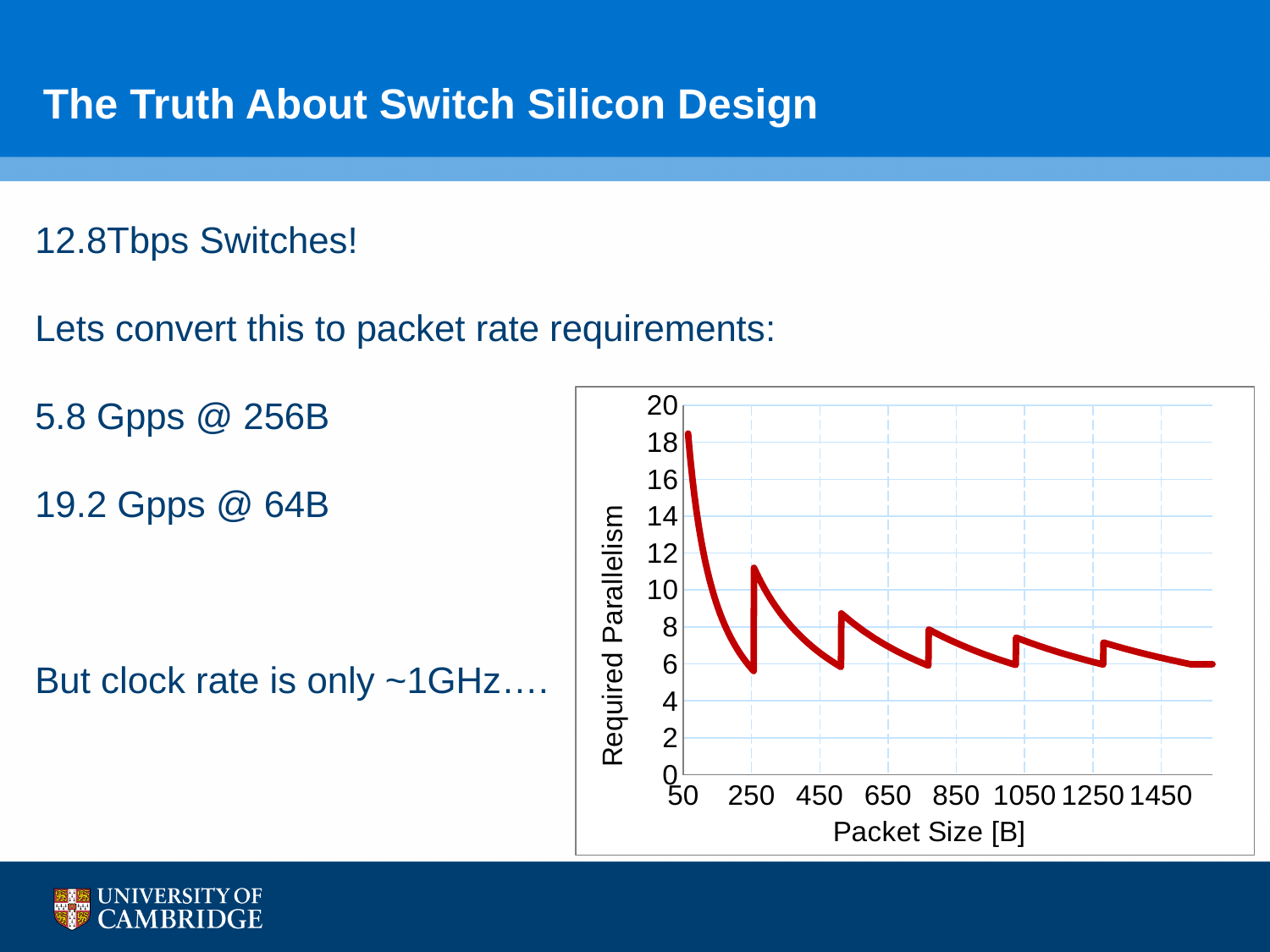
Overall, does the required parallelism rise or fall as packet size increases along the x axis? fall Is the required parallelism at a packet size of 1050 B greater or less than 10? less Is the required parallelism at a packet size of 1450 B greater or less than 8? less What kind of chart is shown on the slide? line chart What is the label of the x axis of the chart? Packet Size [B] What is the highest tick value shown on the y axis of the chart? 20 Is the required parallelism at a packet size of 50 B greater or less than 16? greater What is the label of the y axis of the chart? Required Parallelism Is the required parallelism at a packet size of 50 B greater or less than the value at 1450 B? greater